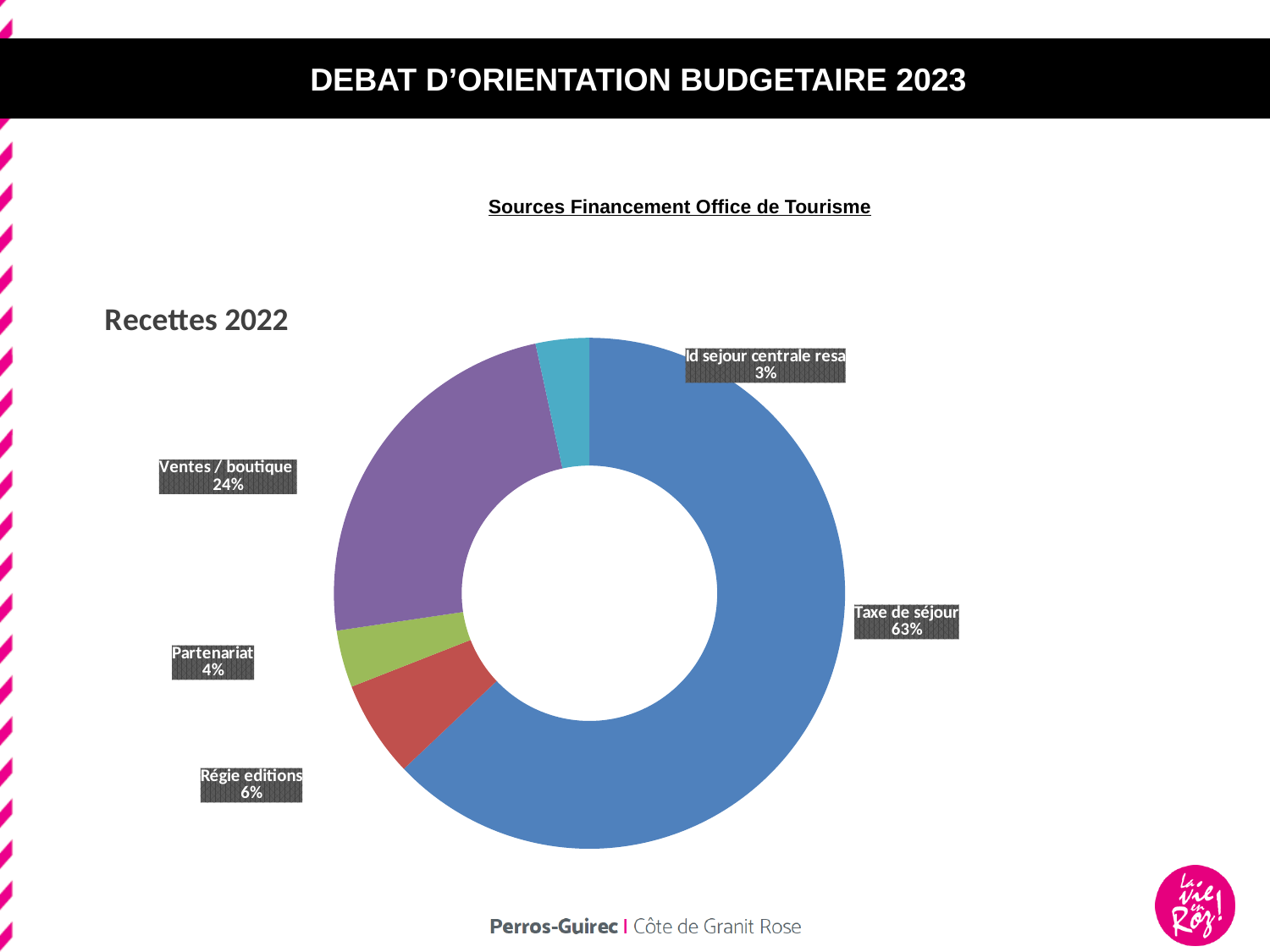
What share of Recettes 2022 comes from Ventes / boutique? 24% What kind of chart is shown on the slide? Doughnut (pie) chart Which category has the largest share of Recettes 2022? Taxe de séjour What percentage is shown for Id sejour centrale resa? 3% Which category has the smallest share of Recettes 2022? Id sejour centrale resa What is the difference in percentage points between Taxe de séjour and Ventes / boutique? 39 What percentage is shown for Partenariat? 4% What is the title of the chart? Recettes 2022 What percentage is shown for Régie editions? 6% Which is larger, the share for Régie editions or the share for Partenariat? Régie editions What share of Recettes 2022 comes from Taxe de séjour? 63% How many categories are shown in the chart? 5